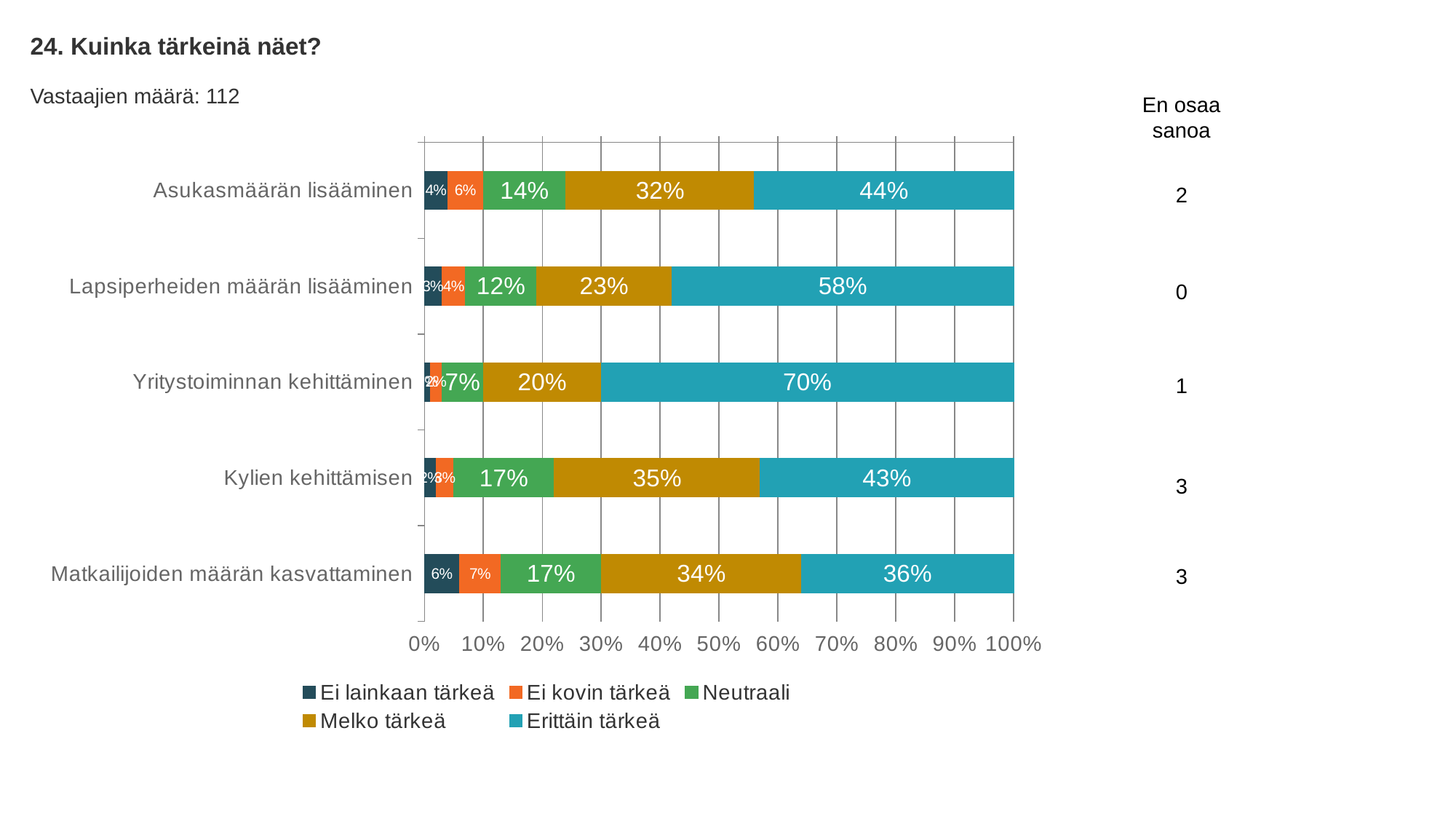
Which category has the highest 'Erittäin tärkeä' value? Yritystoiminnan kehittäminen What is the 'Neutraali' value for Lapsiperheiden määrän lisääminen? 12% Which category has the lowest 'Erittäin tärkeä' value? Matkailijoiden määrän kasvattaminen How many categories are plotted on the chart? 5 What is the 'Erittäin tärkeä' value for Yritystoiminnan kehittäminen? 70% What is the 'Melko tärkeä' value for Kylien kehittämisen? 35% Which is larger: the 'Melko tärkeä' value for Asukasmäärän lisääminen or for Matkailijoiden määrän kasvattaminen? Matkailijoiden määrän kasvattaminen What kind of chart is shown on the slide? Stacked bar chart What is the 'En osaa sanoa' count shown for Kylien kehittämisen? 3 How many series does the legend list? 5 What is the difference between the 'Erittäin tärkeä' values for Lapsiperheiden määrän lisääminen and Asukasmäärän lisääminen? 14% What is the 'Ei kovin tärkeä' value for Matkailijoiden määrän kasvattaminen? 7%